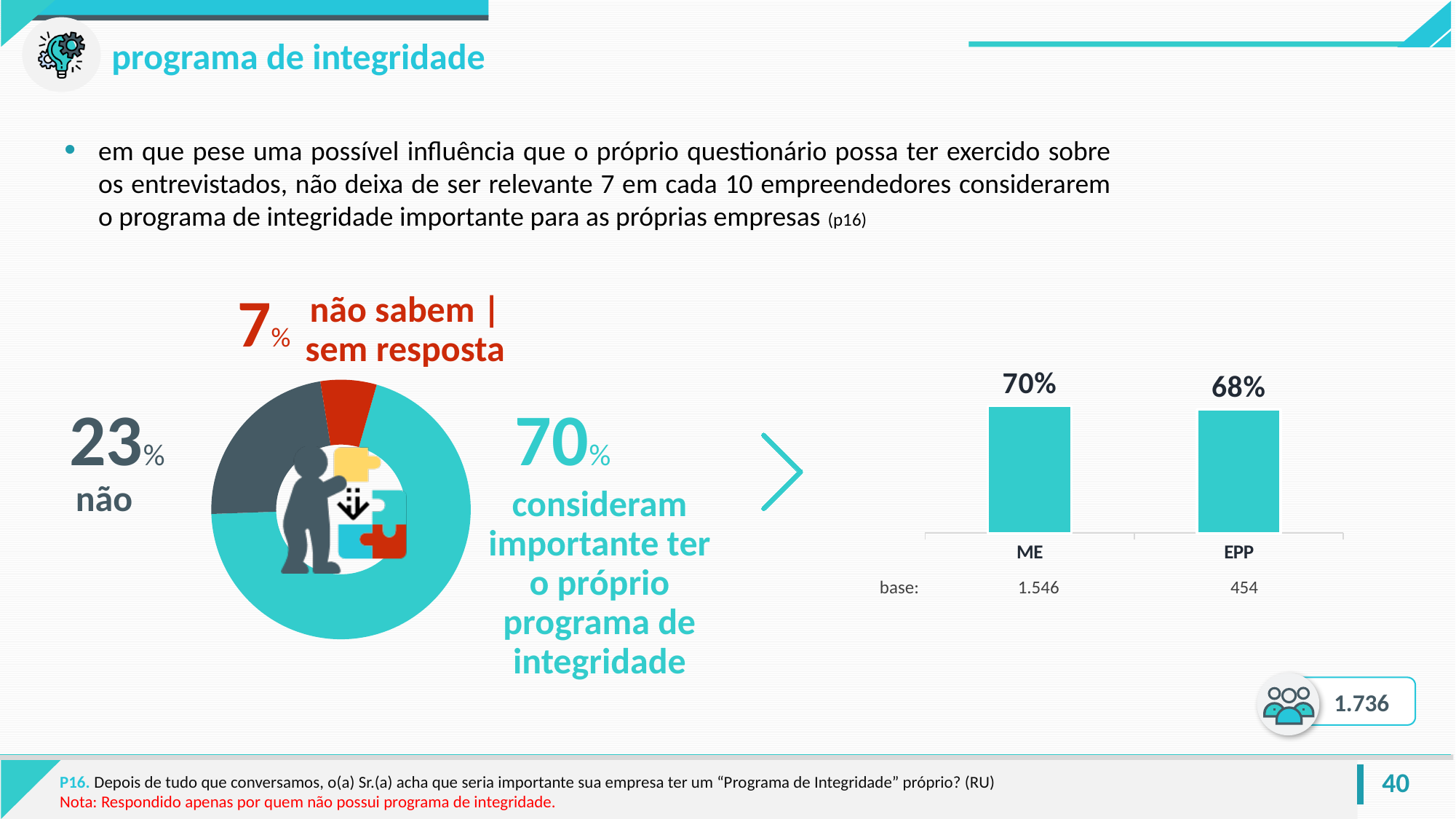
In the pie chart on the left, which slice is the smallest? não sabem | sem resposta In the bar chart on the right, what is the base (sample size) shown for ME? 1.546 In the bar chart on the right, how many categories are shown? 2 In the bar chart on the right, which category has the higher value, ME or EPP? ME In the bar chart on the right, what is the difference between the values for ME and EPP? 2% What kind of chart is shown on the left side of the slide? doughnut chart In the pie chart on the left, what share of respondents answered 'não'? 23% In the bar chart on the right, what is the value for ME? 70% In the bar chart on the right, what is the value for EPP? 68% In the pie chart on the left, what share of respondents answered 'não sabem | sem resposta'? 7% What kind of chart is shown on the right side of the slide? bar chart In the pie chart on the left, what share of respondents consider it important to have their own integrity program? 70%